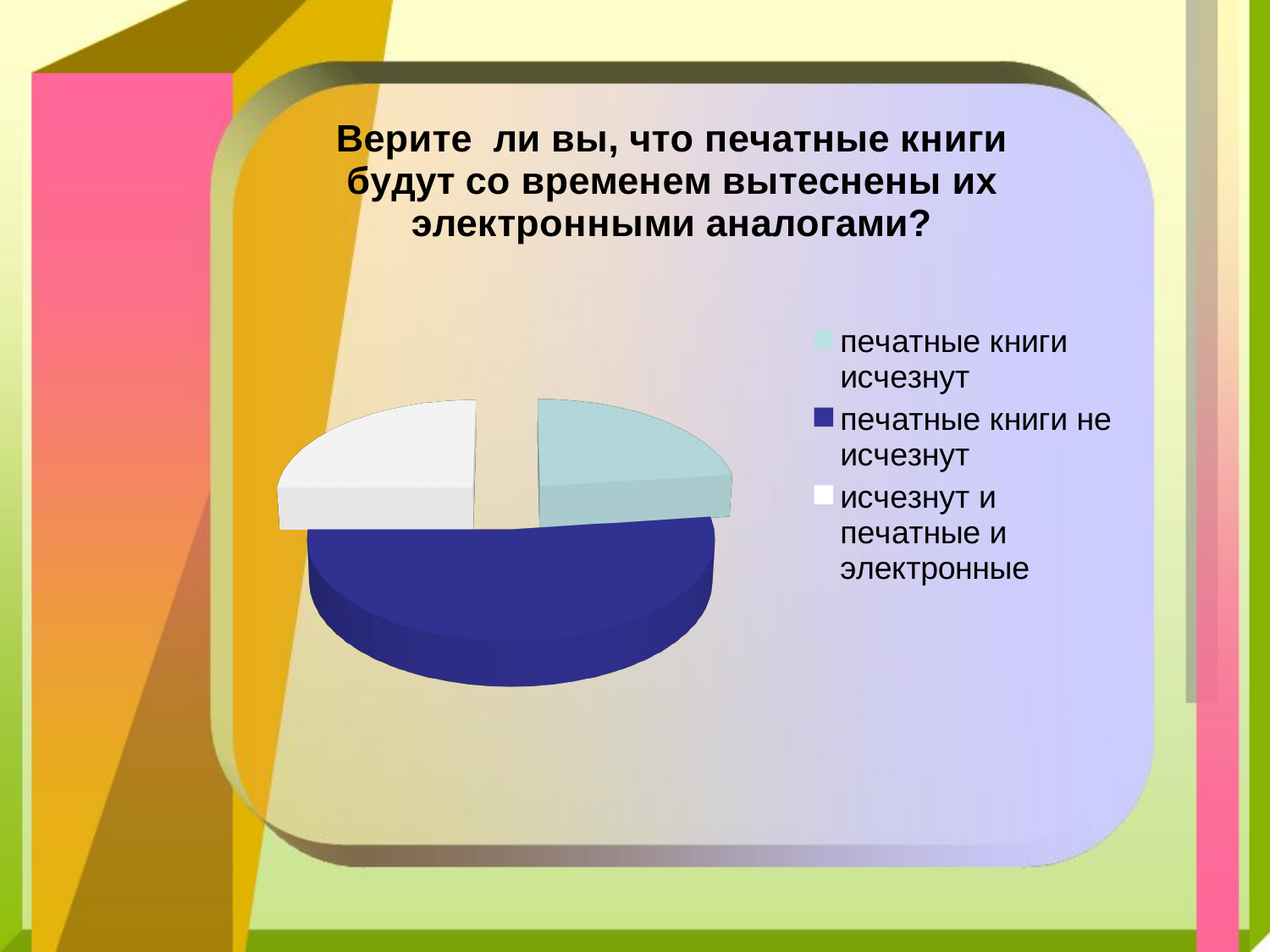
How many entries does the legend of the pie chart list? 3 What kind of chart is shown on the slide? pie chart Which category has the largest slice in the pie chart? печатные книги не исчезнут Which legend entry is shown in dark blue? печатные книги не исчезнут Which slice is larger: "печатные книги не исчезнут" or "печатные книги исчезнут"? печатные книги не исчезнут How many slices does the pie chart have? 3 What question is posed in the title above the pie chart? Верите ли вы, что печатные книги будут со временем вытеснены их электронными аналогами? Which slice is larger: "печатные книги не исчезнут" or "исчезнут и печатные и электронные"? печатные книги не исчезнут